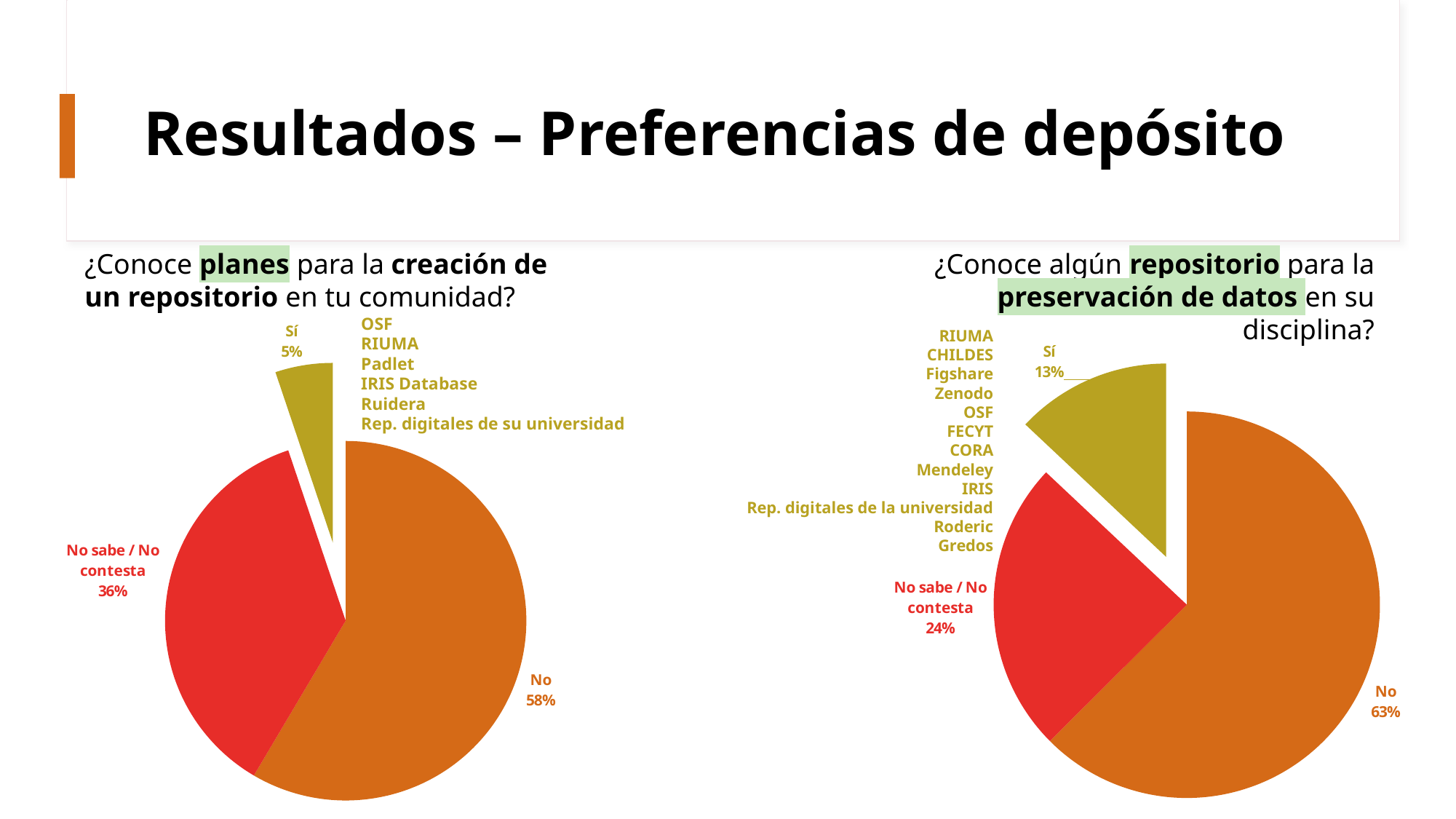
In the right pie chart (¿Conoce algún repositorio para la preservación de datos en su disciplina?), what share is labelled for 'Sí'? 13% How many slices does the right pie chart have? 3 In the left pie chart, which category has the largest slice? No In the right pie chart, what share is labelled for 'No'? 63% In the right pie chart, which category has the smallest slice? Sí In the left pie chart, what share is labelled for 'Sí'? 5% In the left pie chart, what share is labelled for 'No sabe / No contesta'? 36% In the right pie chart, what share is labelled for 'No sabe / No contesta'? 24% In the left pie chart (¿Conoce planes para la creación de un repositorio en tu comunidad?), what share is labelled for 'No'? 58% What type of chart is used on the left side of the slide? Pie chart Which is larger: the 'Sí' share in the left pie chart or the 'Sí' share in the right pie chart? The right pie chart (13%) In the left pie chart, what is the difference between the 'No' share and the 'No sabe / No contesta' share? 22%